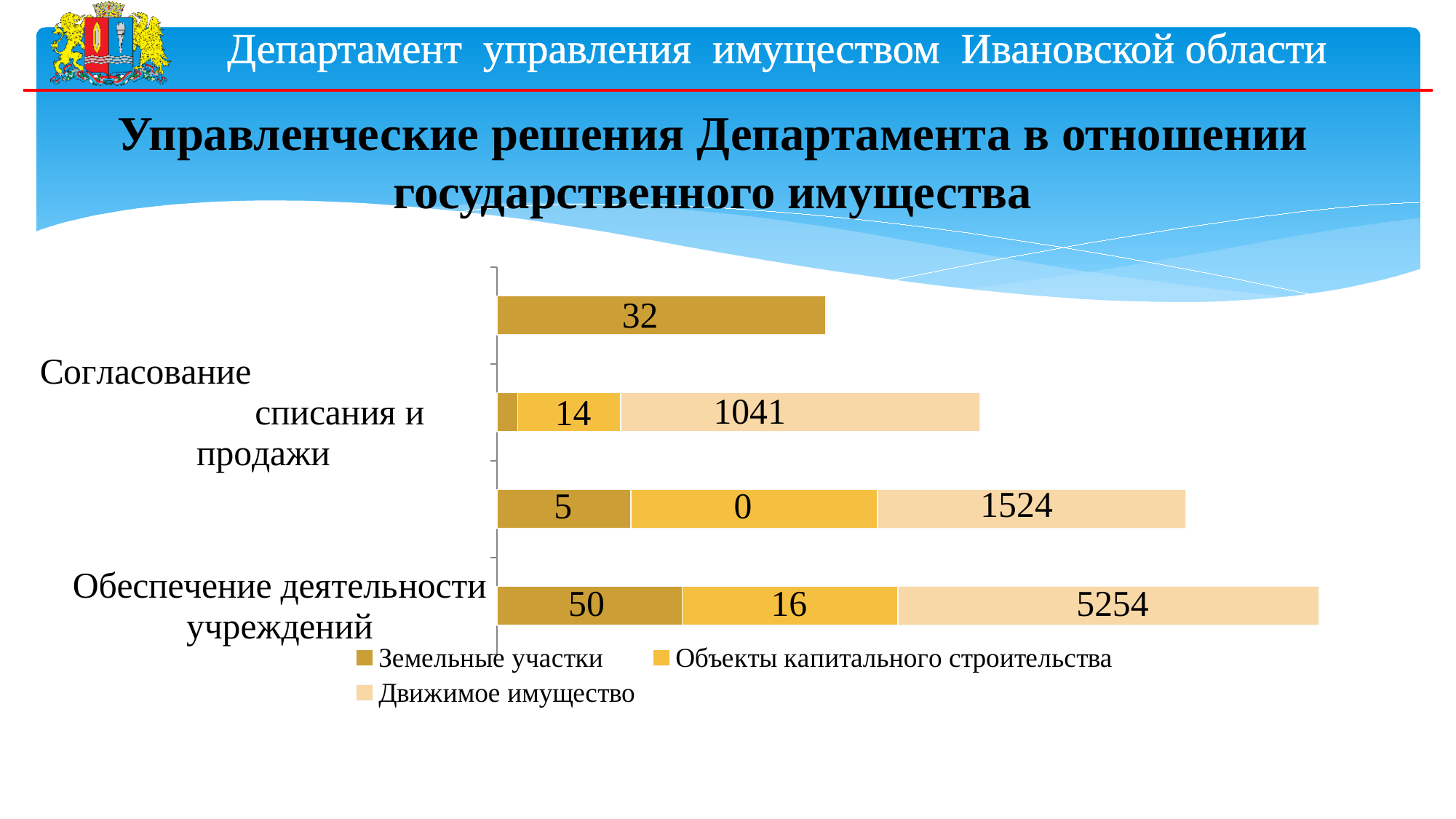
How many series does the chart legend list? 3 What kind of chart is shown on the slide? Bar chart Which bar has the largest Движимое имущество value? The bottom bar (5254) What is the difference between the Движимое имущество values of the bottom bar and the third bar from the top? 3730 What is the value of Объекты капитального строительства in the third bar from the top? 0 What is the total of the bottom stacked bar? 5320 What is the value of Земельные участки in the bottom bar? 50 What is the value of Земельные участки in the top bar? 32 How many bars are plotted in the chart? 4 What is the value of Движимое имущество in the second bar from the top? 1041 Which is larger: the Земельные участки value in the top bar or in the bottom bar? The bottom bar (50) What is the value of Движимое имущество in the bottom bar? 5254